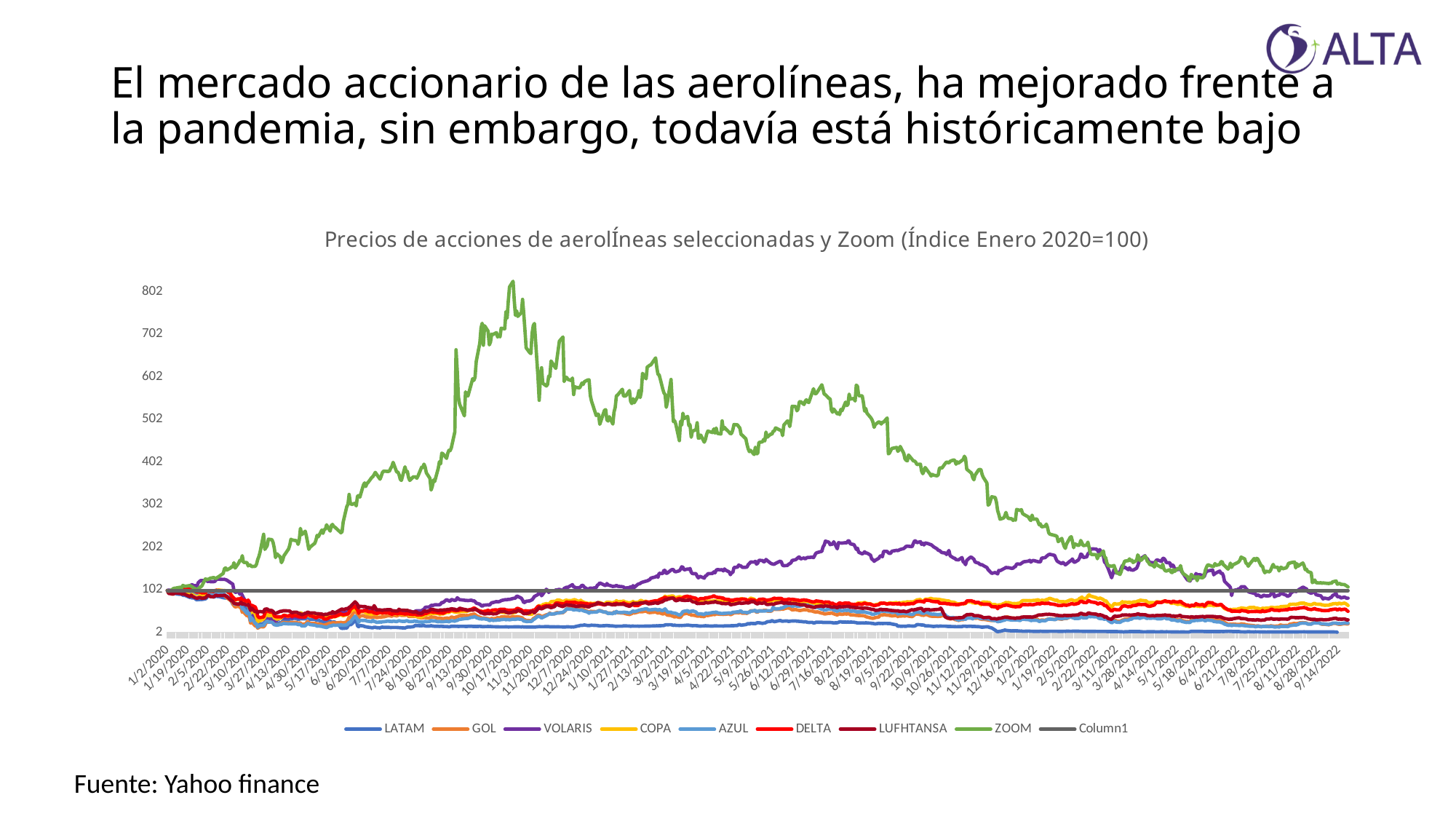
Which series has the lowest value at 9/14/2022? LATAM Is the peak value of the ZOOM series greater or less than 702? greater What is the title of the chart? Precios de acciones de aerolÍneas seleccionadas y Zoom (Índice Enero 2020=100) Is the value for LATAM at 9/14/2022 greater or less than 102? less How many series does the legend list? 9 Around 10/17/2020, which series has the larger value, ZOOM or LATAM? ZOOM What kind of chart is shown on the slide? line chart Which series reaches the highest value on the chart? ZOOM Does the ZOOM series rise or fall between 10/17/2020 and 9/14/2022? fall Which series is drawn in green? ZOOM Does the ZOOM series rise or fall between 1/2/2020 and 10/17/2020? rise